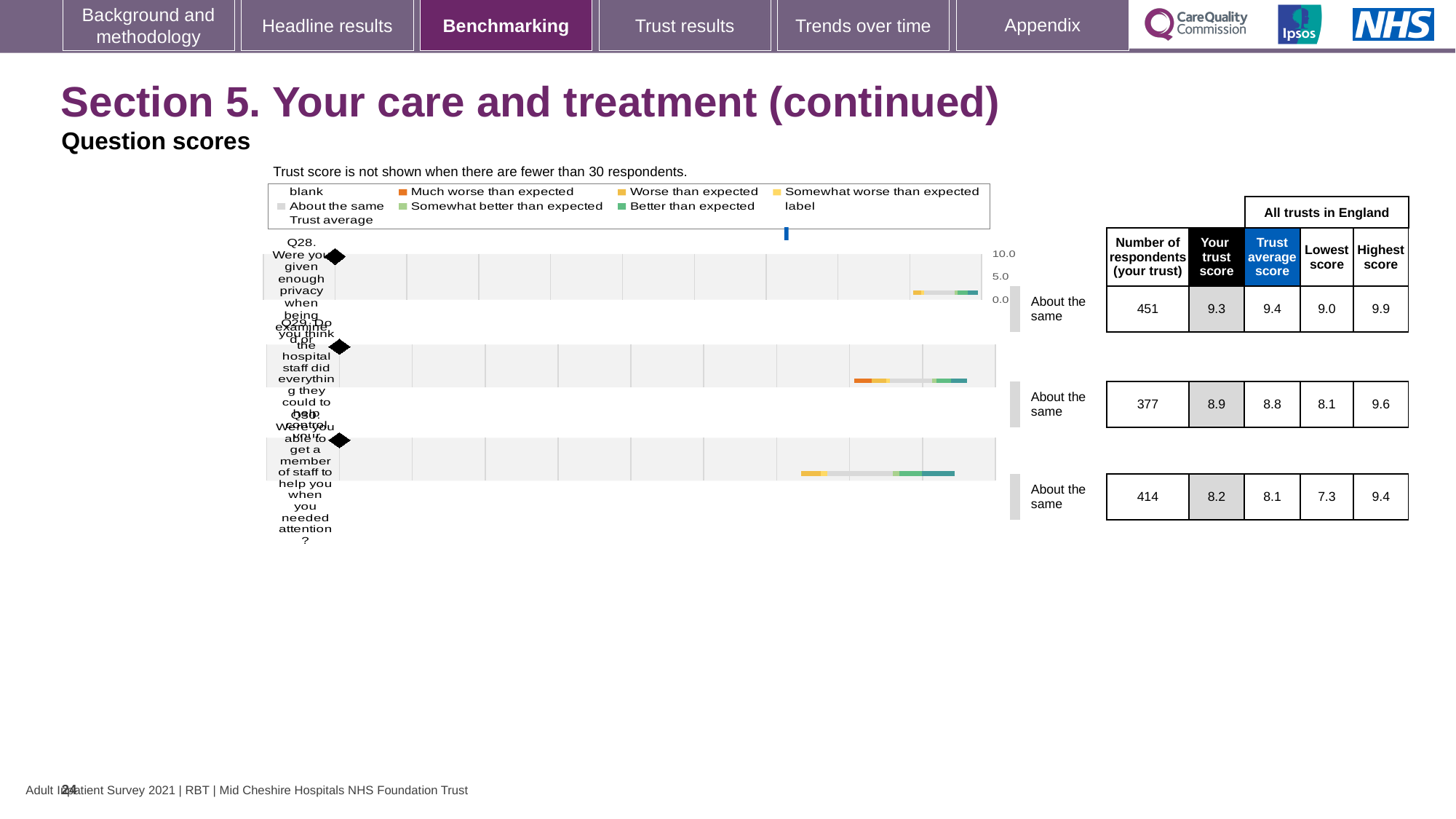
What is the highest score across all trusts in England for Q29? 9.6 How many respondents answered Q29 for your trust? 377 Which of the three questions has the highest trust score? Q28 What benchmark category is shown next to the Q28 chart? About the same Which of the three questions has the lowest trust score? Q30 What kind of chart is used to show the question scores for Q28, Q29 and Q30? bar chart For Q29, which is larger: your trust score or the trust average score? your trust score What is the difference between the trust score for Q28 and the trust score for Q29? 0.4 What is the trust score for Q28 (Were you given enough privacy when being examined or treated)? 9.3 What is the trust average score for Q30 (Were you able to get a member of staff to help you when you needed attention)? 8.1 What is the lowest score across all trusts in England for Q30? 7.3 How many questions (Q28, Q29, Q30) are charted on the slide? 3